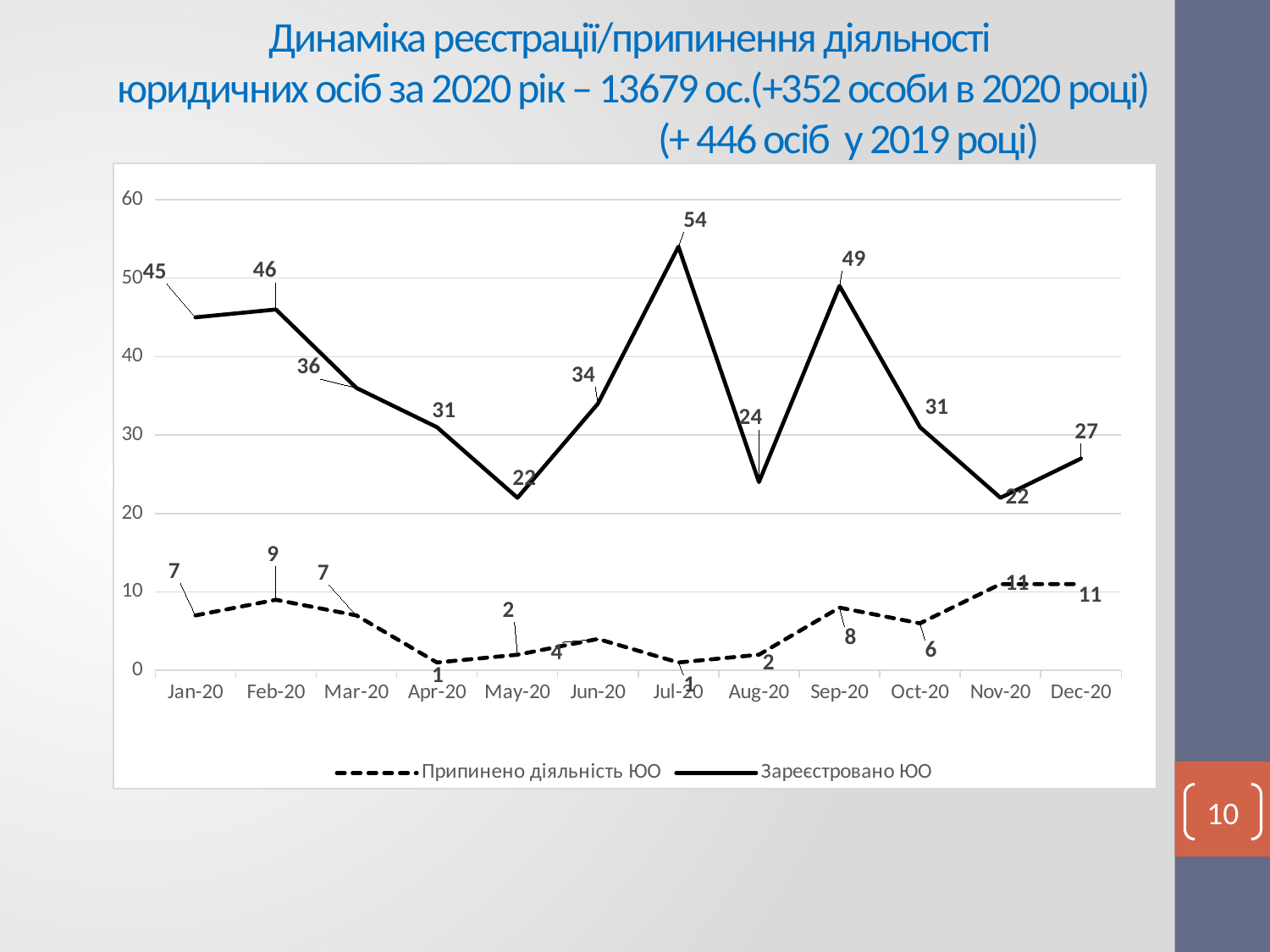
Does Зареєстровано ЮО rise or fall from Jan-20 to May-20? fall How many series does the legend list? 2 Is the value for Зареєстровано ЮО in Sep-20 greater or less than 40? greater In which month is Зареєстровано ЮО highest? Jul-20 What is the value for Припинено діяльність ЮО in Sep-20? 8 In which month is Припинено діяльність ЮО lowest? Apr-20 and Jul-20 Which series is drawn with a dashed line? Припинено діяльність ЮО How many months are plotted along the x axis? 12 What is the difference between Зареєстровано ЮО in Jul-20 and Aug-20? 30 What is the value for Зареєстровано ЮО in Jul-20? 54 Which is larger for Зареєстровано ЮО: Feb-20 or Mar-20? Feb-20 What type of chart is shown on the slide? line chart